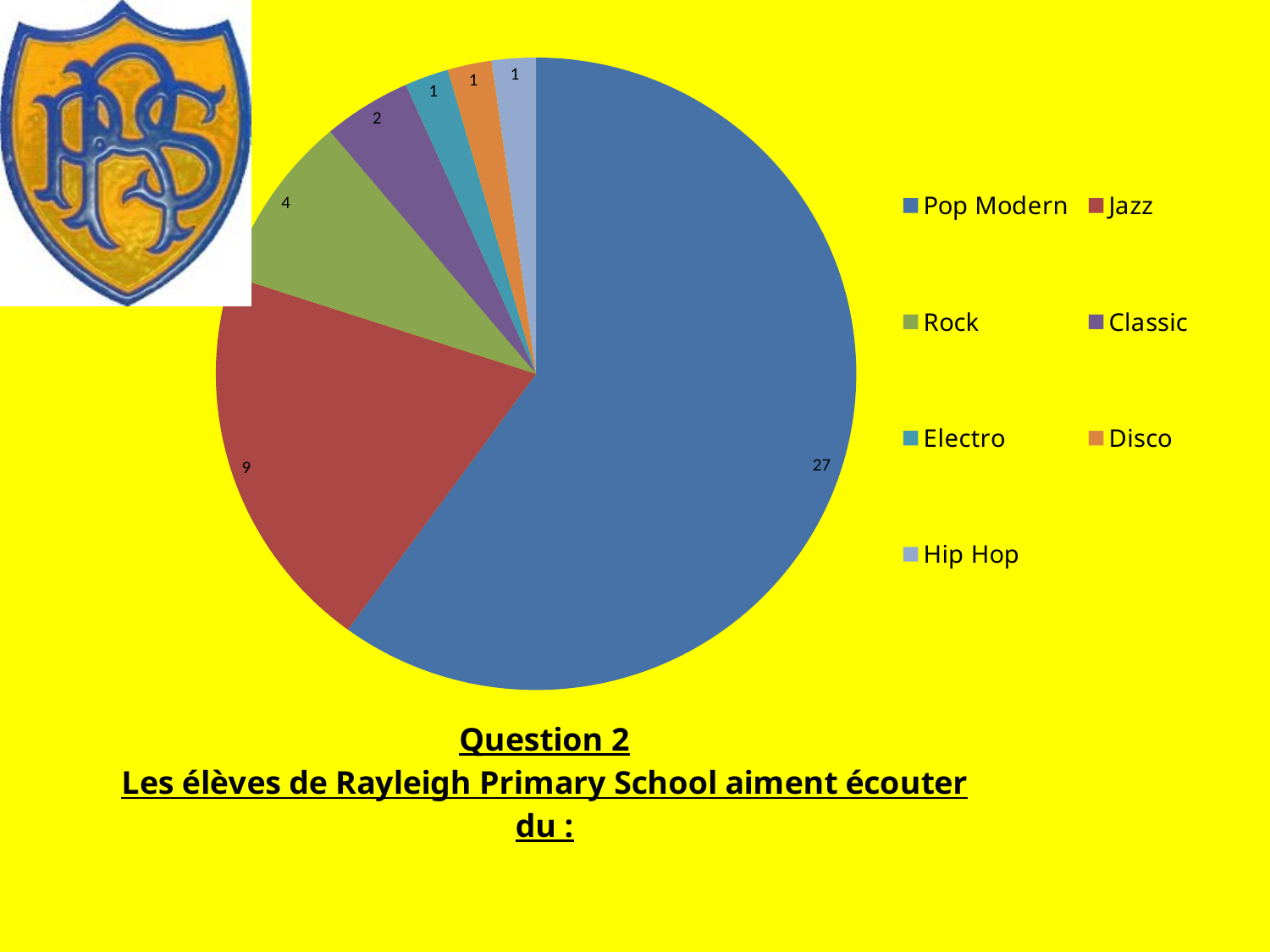
What kind of chart is shown on the slide? pie chart How many students like Pop Modern? 27 What is the total of all the slices in the pie chart? 45 What is the value for Rock? 4 What colour is the Jazz slice? red What is the value for Classic? 2 What is the value for Jazz? 9 What share of the pie does Pop Modern represent? 60% How many genres does the legend list? 7 Which music genre has the largest slice? Pop Modern What is the difference between the values for Pop Modern and Jazz? 18 Which is larger, the value for Rock or the value for Classic? Rock